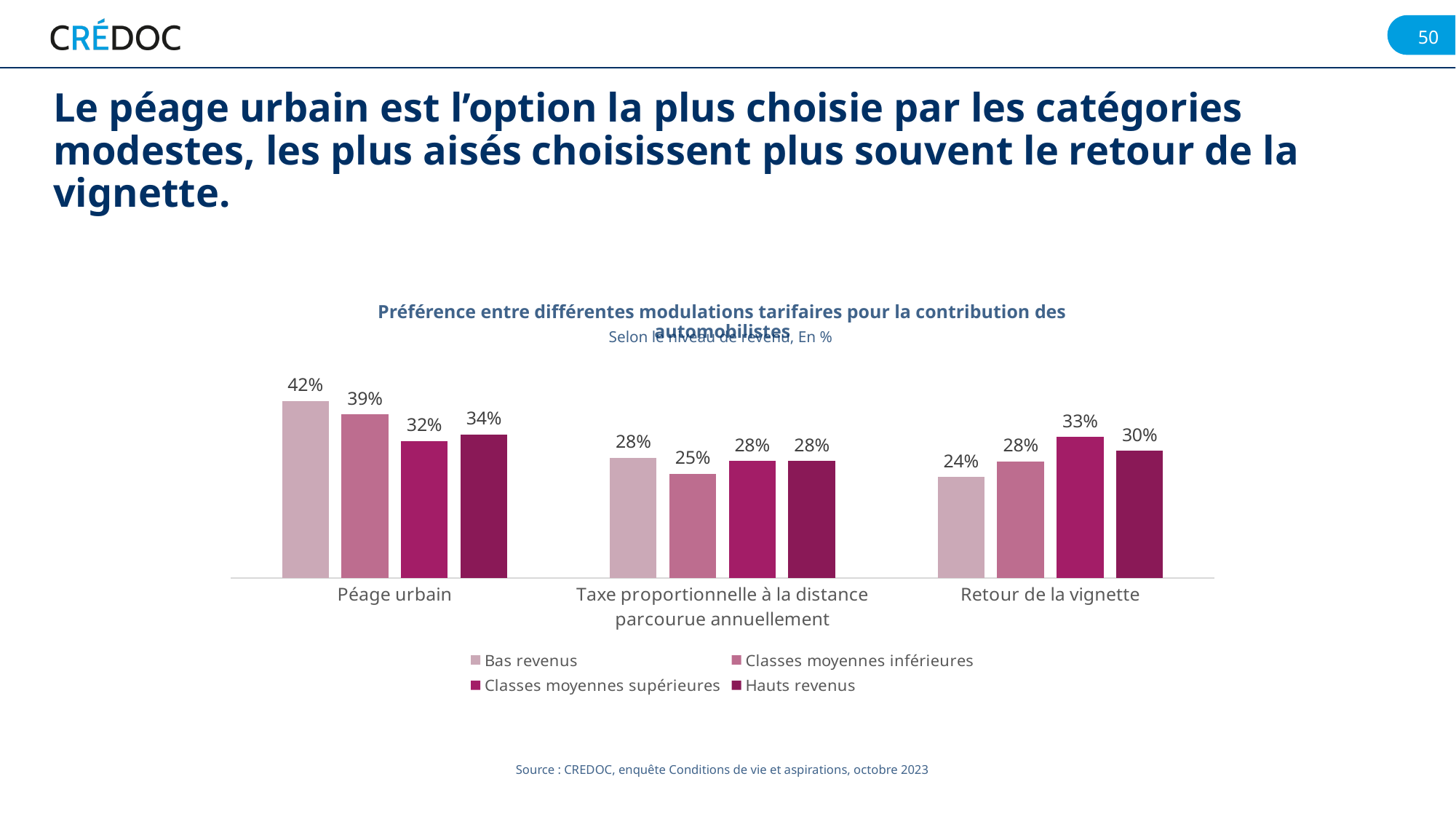
What is the source cited below the chart? CREDOC, enquête Conditions de vie et aspirations, octobre 2023 Which is larger for Classes moyennes supérieures: Péage urbain or Retour de la vignette? Retour de la vignette What kind of chart is shown on the slide? Bar chart Which income group has the highest value in the Péage urbain category? Bas revenus What is the value for Classes moyennes inférieures in the Taxe proportionnelle à la distance parcourue annuellement category? 25% What is the value for Hauts revenus in the Retour de la vignette category? 30% What is the value for Bas revenus in the Péage urbain category? 42% How many categories are shown on the x axis? 3 Which income group has the lowest value in the Retour de la vignette category? Bas revenus What is the difference between the Bas revenus and Hauts revenus values in the Péage urbain category? 8 percentage points How many series does the legend list? 4 Which series is shown in the darkest colour? Hauts revenus